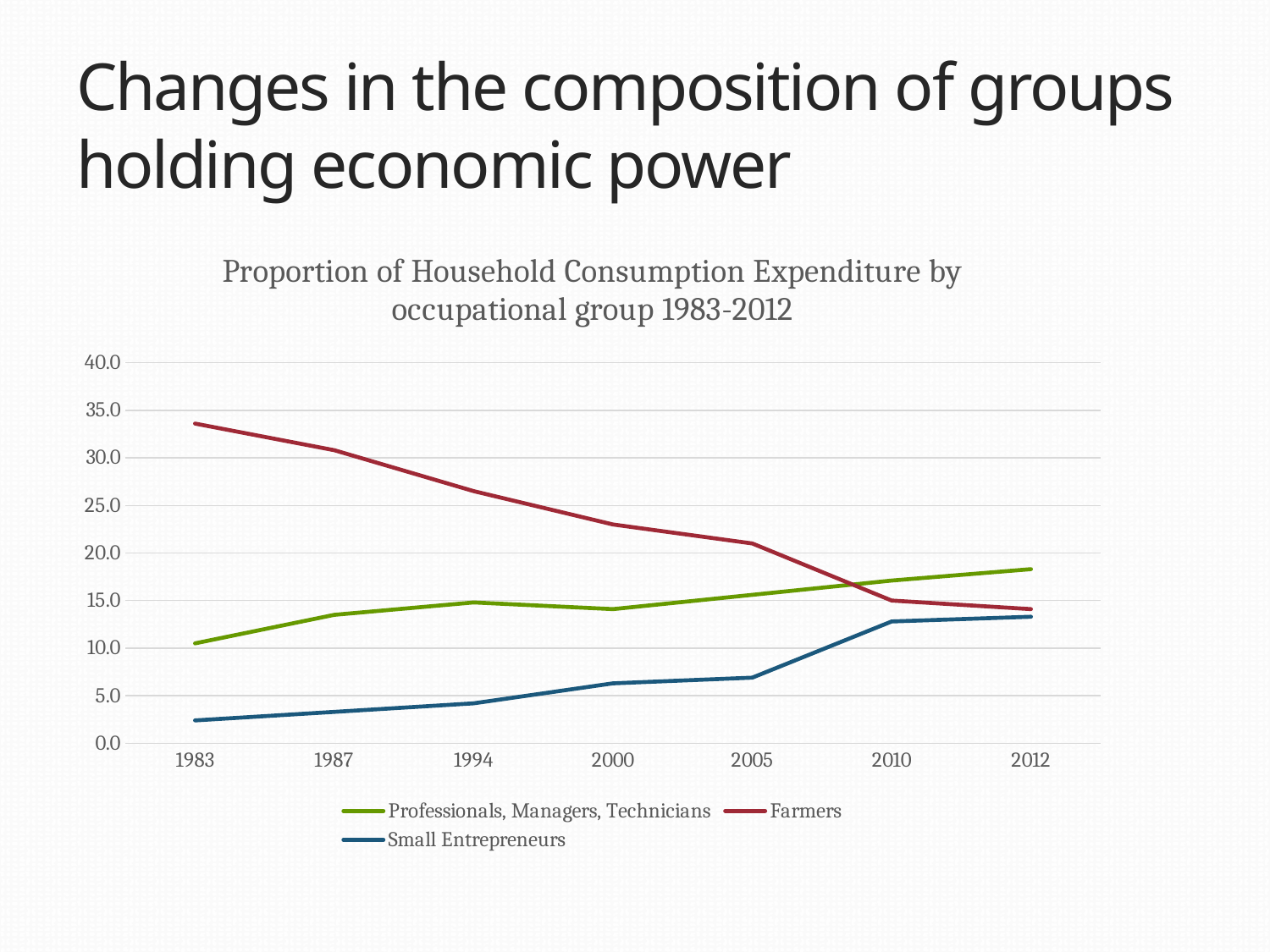
Which occupational group has the highest value in 1983? Farmers How many years are shown along the x axis? 7 Is the value for Professionals, Managers, Technicians in 2012 greater or less than 15.0? greater What kind of chart is shown on the slide? line chart Is the value for Small Entrepreneurs in 1983 greater or less than 5.0? less Is the value for Farmers in 1983 greater or less than 30.0? greater Does the Farmers line rise or fall from 1983 to 2012? fall Does the Small Entrepreneurs line rise or fall from 1983 to 2012? rise What is the title of the chart? Proportion of Household Consumption Expenditure by occupational group 1983-2012 In 2012, which is larger: Professionals, Managers, Technicians or Farmers? Professionals, Managers, Technicians Which occupational group has the lowest value in 2005? Small Entrepreneurs How many series does the legend list? 3